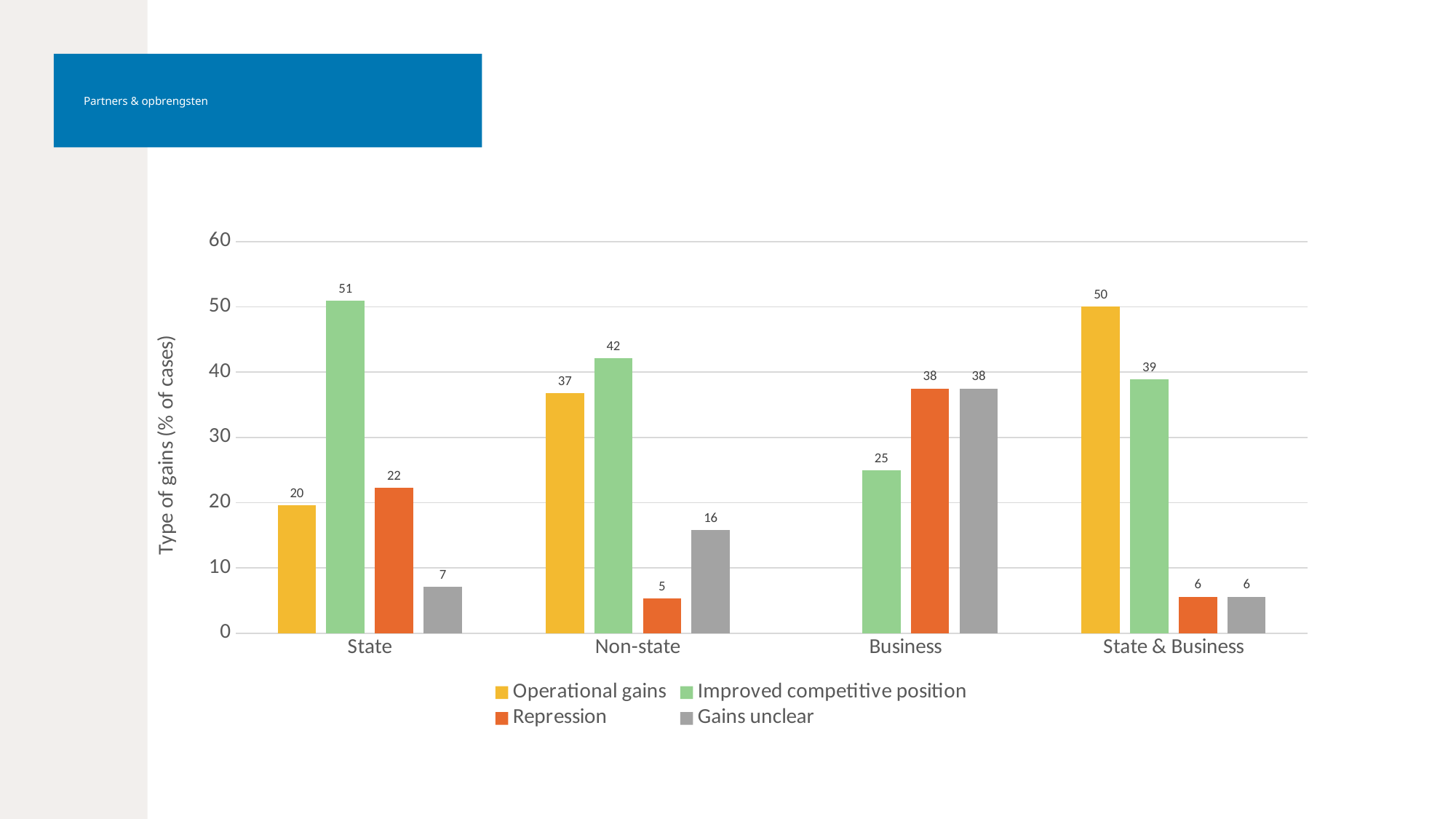
How many series does the legend list? 4 What kind of chart is shown on the slide? Bar chart What is the difference between Improved competitive position and Operational gains in the State category? 31 Which category has the highest value for Operational gains? State & Business What is the label of the vertical axis? Type of gains (% of cases) How many categories are shown on the x axis? 4 What is the value for Gains unclear in the Business category? 38 Which category has the lowest value for Gains unclear? State & Business What is the value for Improved competitive position in the State category? 51 What is the value for Operational gains in the State & Business category? 50 Which is larger in the Non-state category: Operational gains or Improved competitive position? Improved competitive position What is the value for Repression in the Non-state category? 5